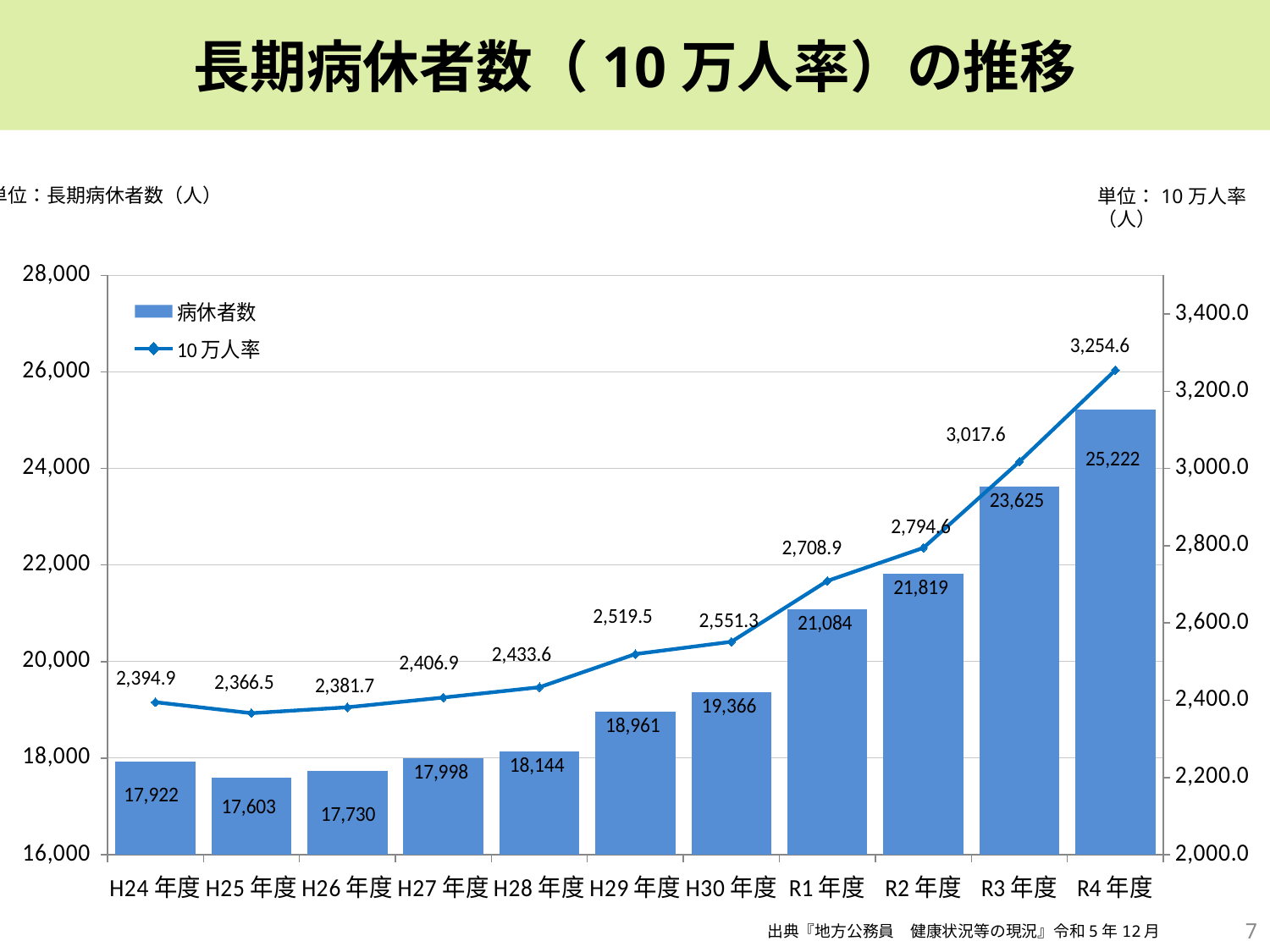
What is the 病休者数 value for H29年度? 18,961 What is the 10万人率 value for H28年度? 2,433.6 Which year has the highest 10万人率? R4年度 What is the difference in 病休者数 between R4年度 and R3年度? 1,597 How many fiscal years are shown on the x axis? 11 How many series does the legend list? 2 What is the 病休者数 value for R4年度? 25,222 What kind of chart is this? Combined bar and line chart Which year has the lowest 病休者数? H25年度 What is the difference in 10万人率 between R1年度 and H30年度? 157.6 Which is larger, the 病休者数 for H26年度 or for H27年度? H27年度 Does the 10万人率 line generally rise or fall from H26年度 to R4年度? Rise